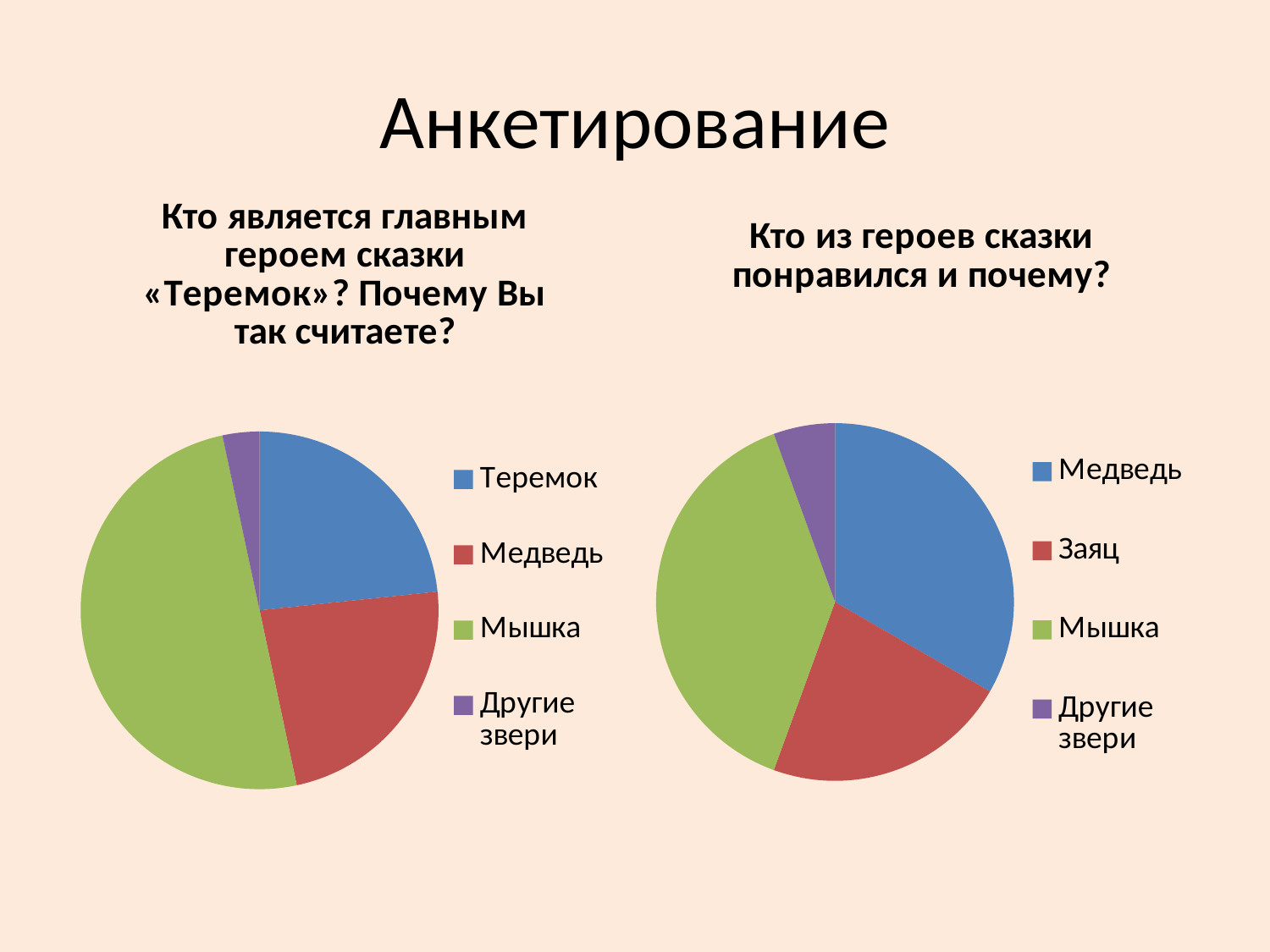
In the left chart, which category has the smallest slice? Другие звери What kind of chart is the right chart ("Кто из героев сказки понравился и почему?")? pie chart In the left chart, what colour is the Мышка slice? green In the left chart, how many categories does the legend list? 4 In the right chart, how many slices does the pie have? 4 What kind of chart is the left chart ("Кто является главным героем сказки «Теремок»?")? pie chart In the right chart, which category is shown in red? Заяц In the right chart, which slice is larger: Медведь or Заяц? Медведь In the right chart, which slice is larger: Мышка or Другие звери? Мышка In the right chart, which category has the smallest slice? Другие звери In the left chart, which category has the largest slice? Мышка In the left chart, which slice is larger: Мышка or Теремок? Мышка